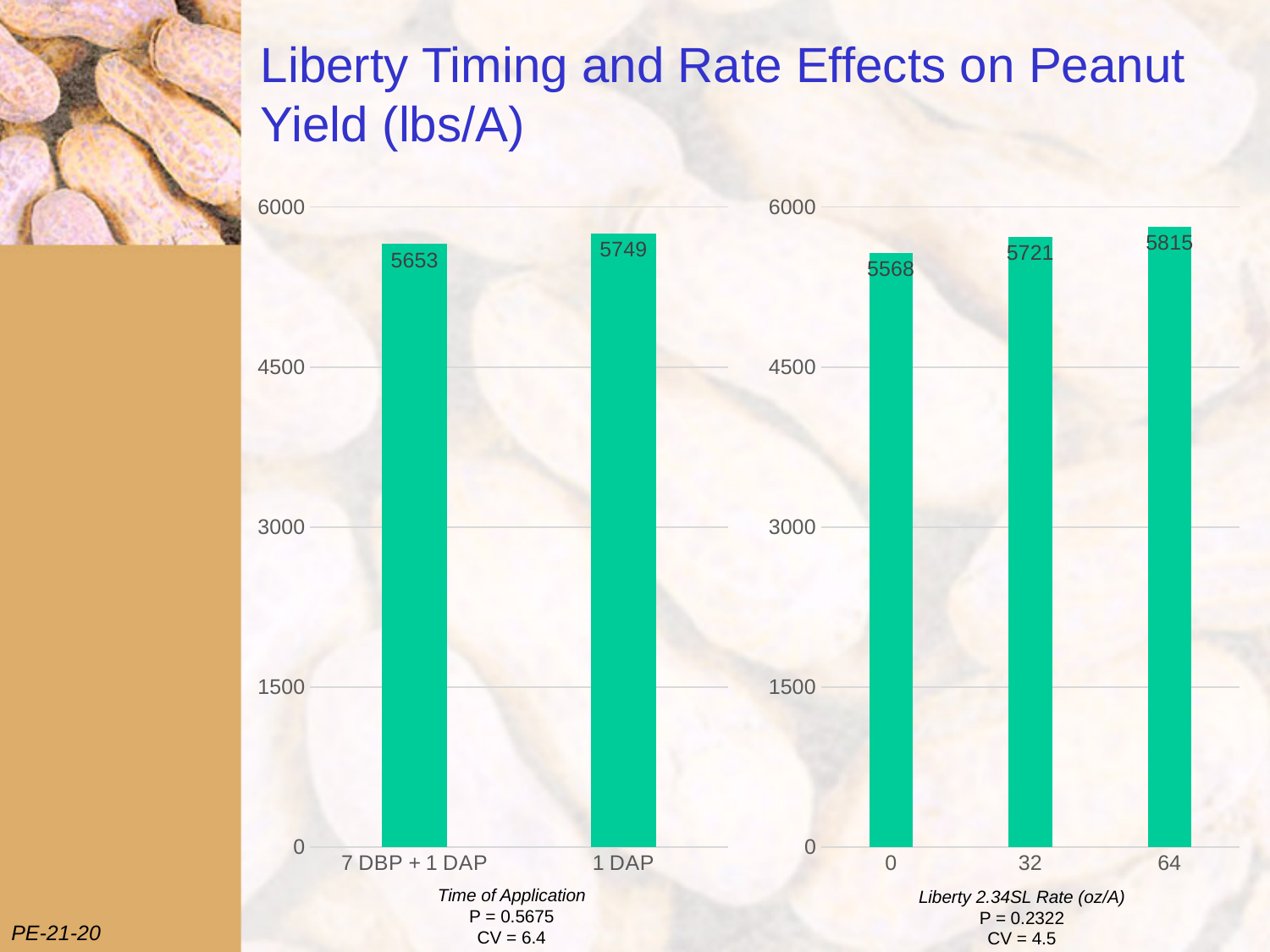
In the right chart (Liberty 2.34SL Rate), what is the difference in yield between the 64 and 0 oz/A rates? 247 In the left chart (Time of Application), how many categories are shown? 2 In the right chart (Liberty 2.34SL Rate), which rate has the highest yield? 64 In the left chart (Time of Application), what is the difference in yield between 1 DAP and 7 DBP + 1 DAP? 96 In the right chart (Liberty 2.34SL Rate), do yields rise or fall as the rate increases from 0 to 64? rise In the left chart (Time of Application), what is the yield for 1 DAP? 5749 In the left chart (Time of Application), what is the yield for 7 DBP + 1 DAP? 5653 In the right chart (Liberty 2.34SL Rate), what is the yield at the 32 oz/A rate? 5721 In the right chart (Liberty 2.34SL Rate), what is the yield at the 0 oz/A rate? 5568 In the right chart (Liberty 2.34SL Rate), which rate has the lowest yield? 0 What kind of chart is the left chart (Time of Application)? bar chart In the right chart (Liberty 2.34SL Rate), how many rate categories are shown? 3